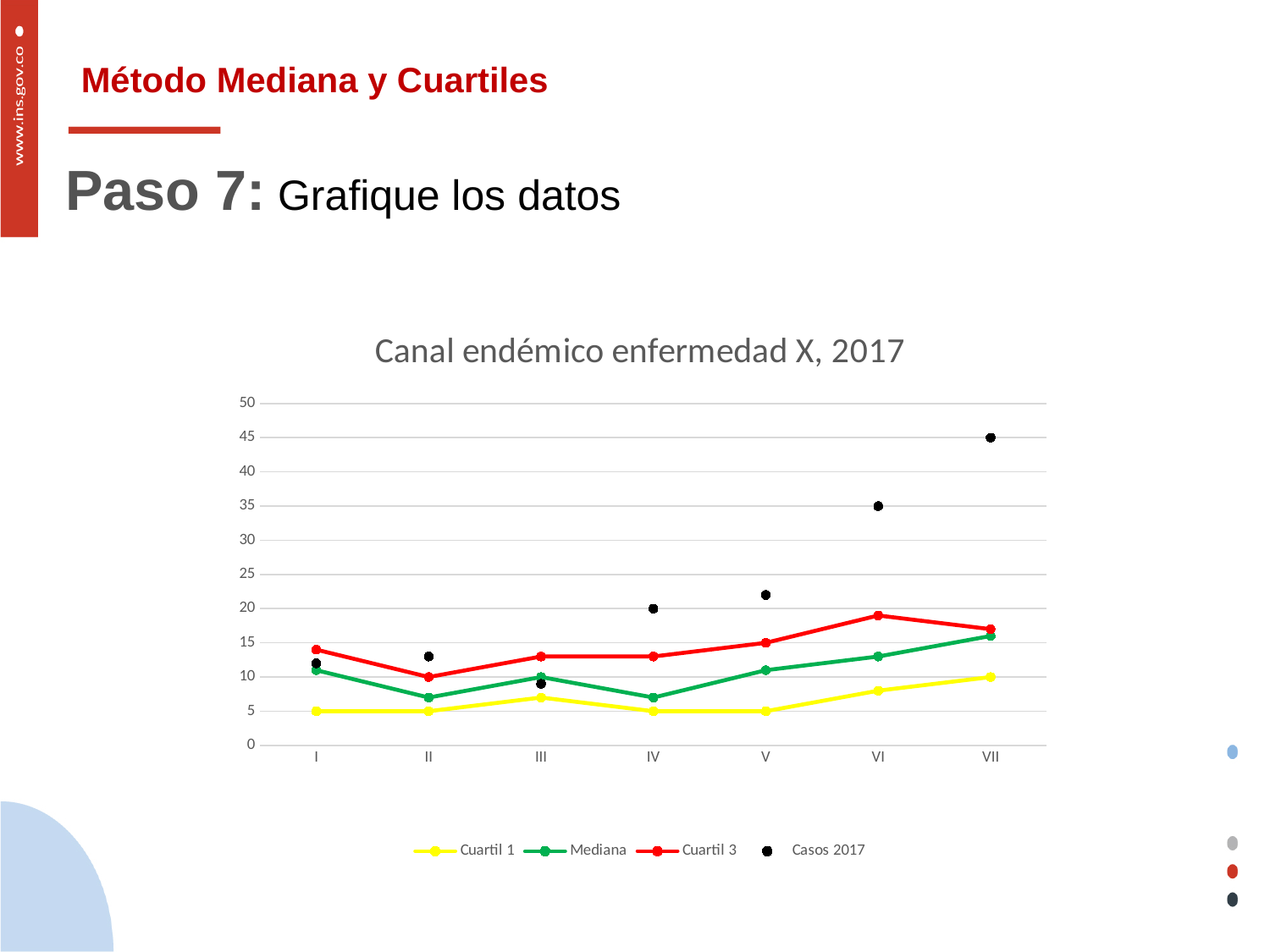
Which is larger at period V: Casos 2017 or Cuartil 3? Casos 2017 Does the Cuartil 3 line rise or fall from period V to period VI? rise Which colour is used for the Mediana series? green At which period is Casos 2017 highest? VII What is the value of Casos 2017 at period VII? 45 What kind of chart is shown on the slide? line chart How many series does the legend list? 4 Is the value of Cuartil 3 at period VI greater or less than 15? greater What is the value of Cuartil 1 at period VII? 10 How many categories are shown on the x axis? 7 What is the title of the chart? Canal endémico enfermedad X, 2017 What is the value of Casos 2017 at period VI? 35